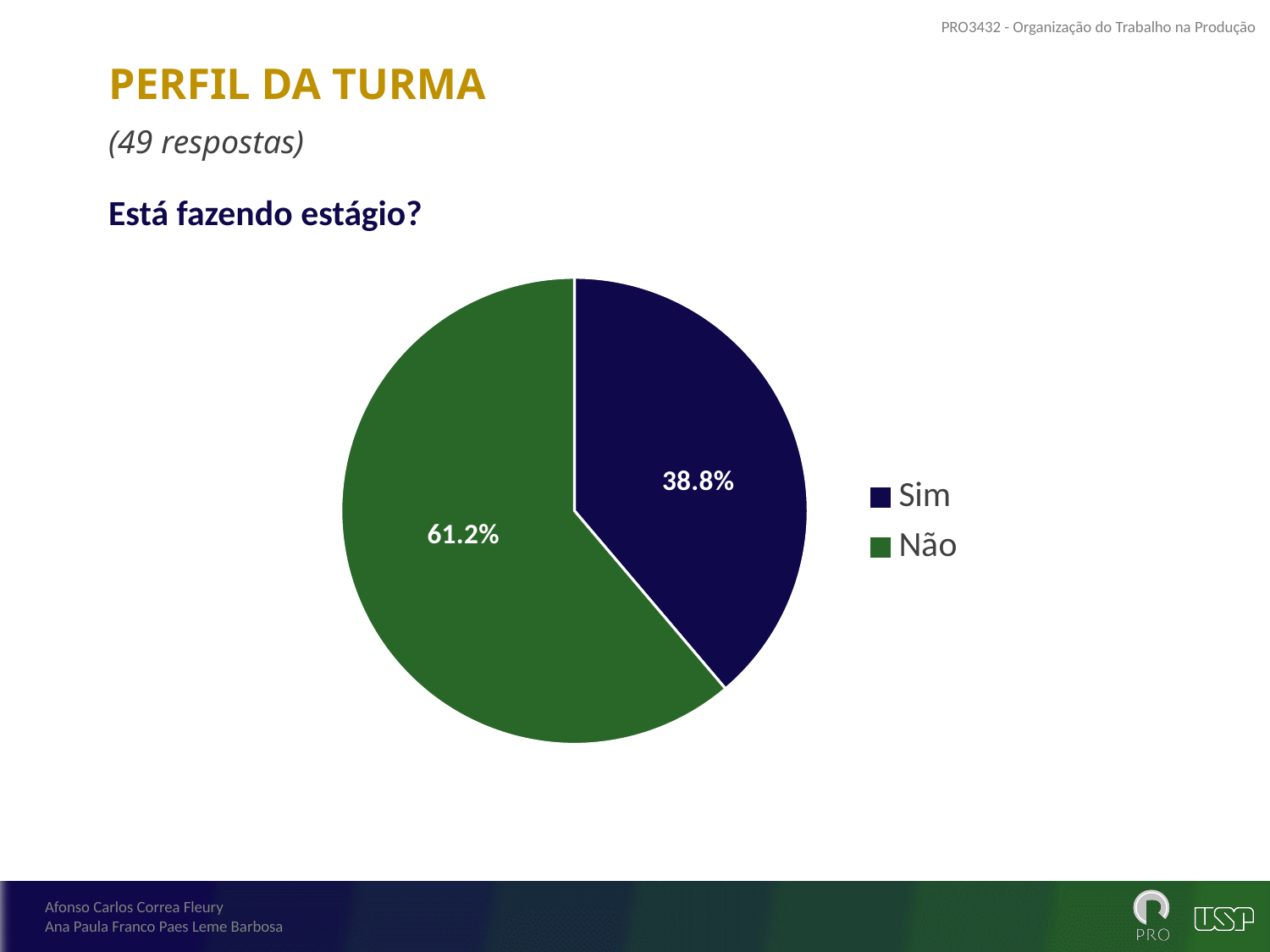
What type of chart is shown on the slide? pie chart What colour is the "Não" slice? green What is the difference in percentage points between "Não" and "Sim"? 22.4 What question does the pie chart answer, according to the heading above it? Está fazendo estágio? What share of the pie does "Sim" represent? 38.8% What share of the pie does "Não" represent? 61.2% Which is larger, the "Sim" slice or the "Não" slice? Não How many slices does the pie chart have? 2 How many responses does the slide say the chart is based on? 49 How many entries does the legend list? 2 Which slice is the smallest? Sim Which slice is the largest? Não